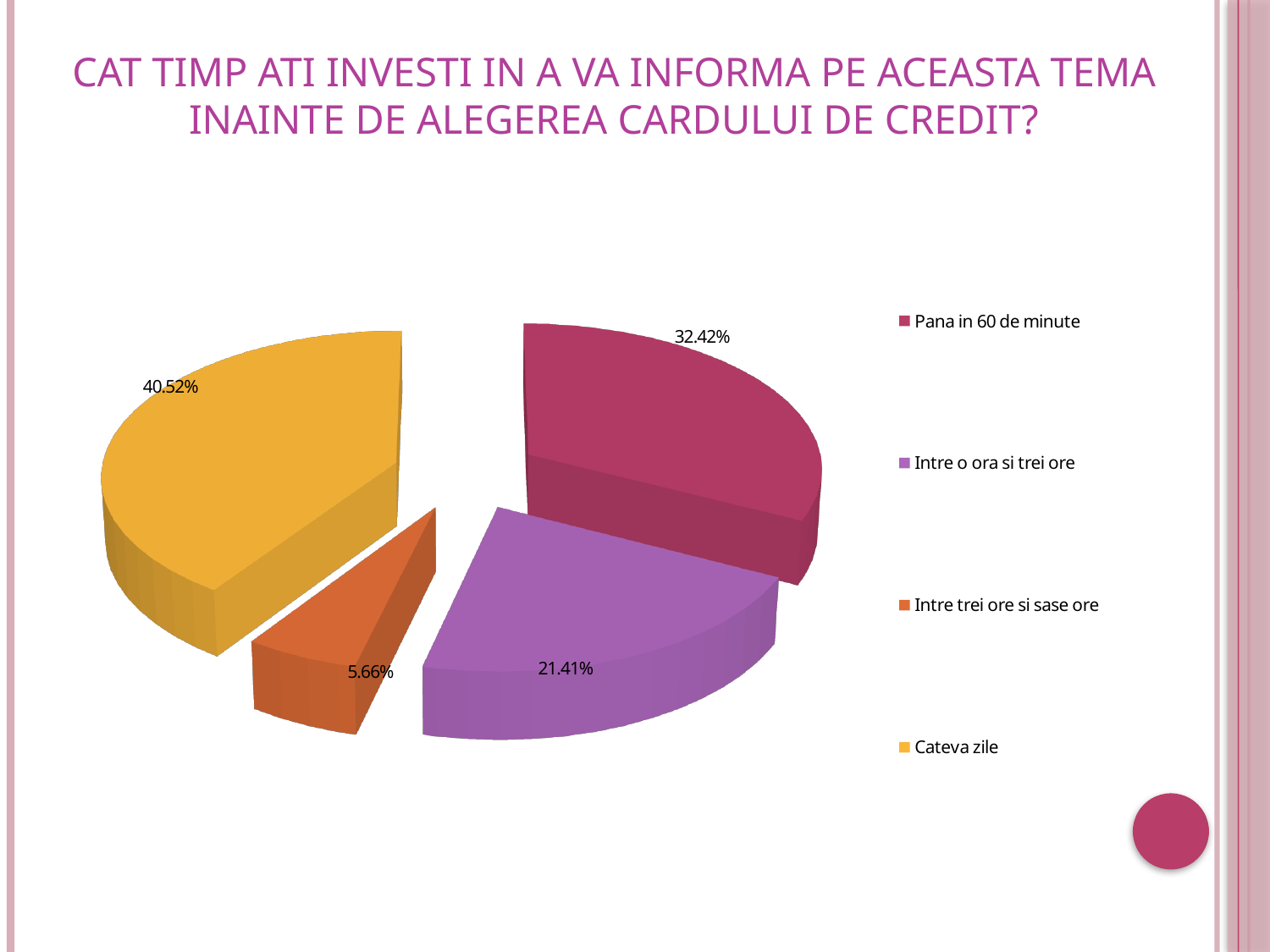
What is the difference in percentage points between "Intre o ora si trei ore" and "Intre trei ore si sase ore"? 15.75 What percentage of respondents chose "Cateva zile"? 40.52% What percentage of respondents chose "Pana in 60 de minute"? 32.42% Which is larger: the share for "Pana in 60 de minute" or the share for "Intre o ora si trei ore"? Pana in 60 de minute Which category has the largest share of the pie? Cateva zile What percentage of respondents chose "Intre o ora si trei ore"? 21.41% What colour is the slice for "Cateva zile"? Yellow How many categories are shown in the pie chart? 4 What type of chart is shown on the slide? Pie chart Which category has the smallest share of the pie? Intre trei ore si sase ore What is the difference in percentage points between "Cateva zile" and "Pana in 60 de minute"? 8.10 What percentage of respondents chose "Intre trei ore si sase ore"? 5.66%